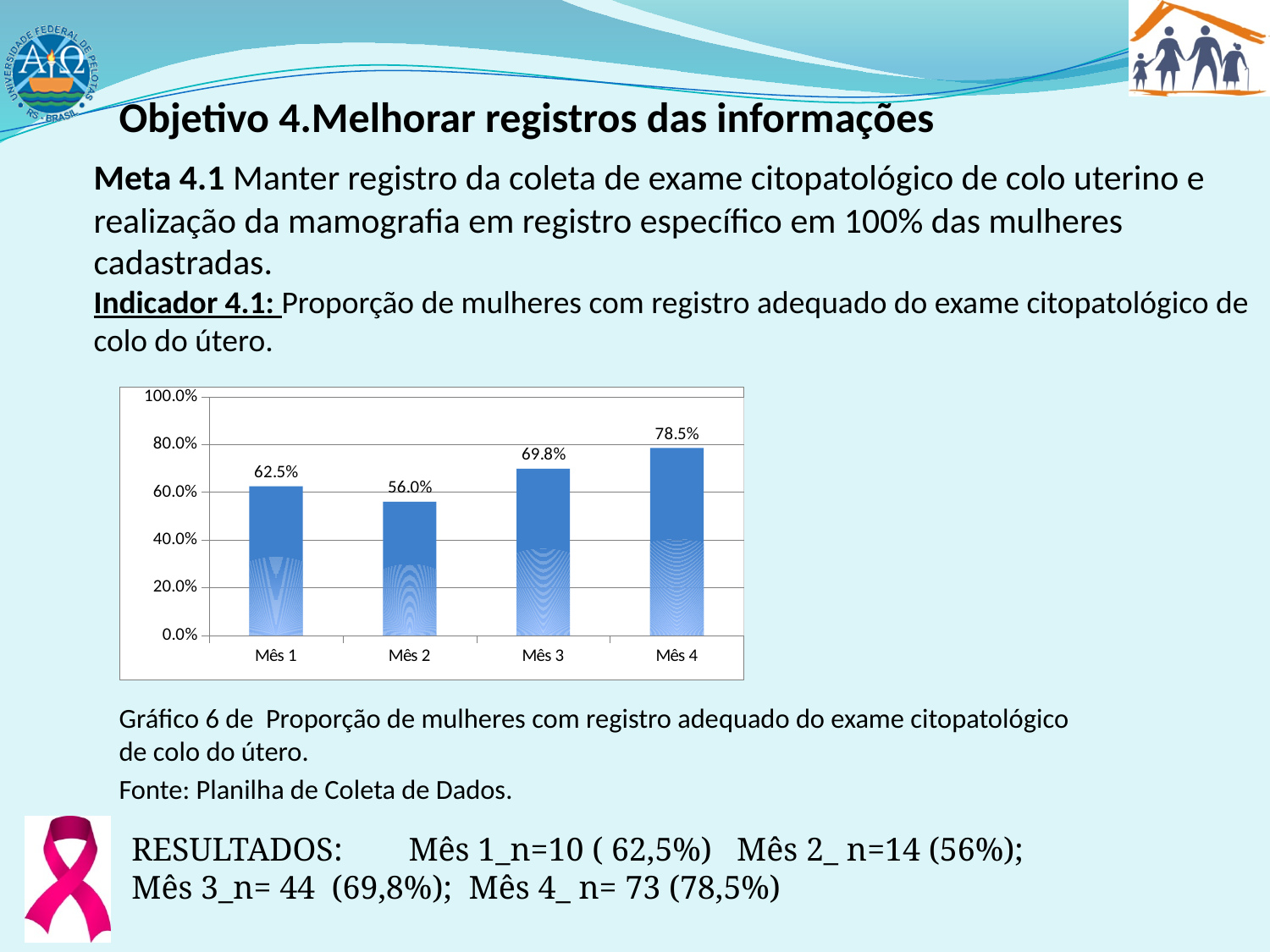
What is the value for Mês 3? 69.8% What kind of chart is shown on the slide? bar chart What is the value for Mês 2? 56.0% Which month has the highest value? Mês 4 What is the value for Mês 4? 78.5% What is the difference between the values for Mês 4 and Mês 1? 16.0% Is the value for Mês 2 greater or less than 60.0%? less Which month has the lowest value? Mês 2 What is the value for Mês 1? 62.5% Does the value rise or fall from Mês 2 to Mês 4? rise How many months are shown on the x axis? 4 Which is larger, the value for Mês 2 or the value for Mês 3? Mês 3